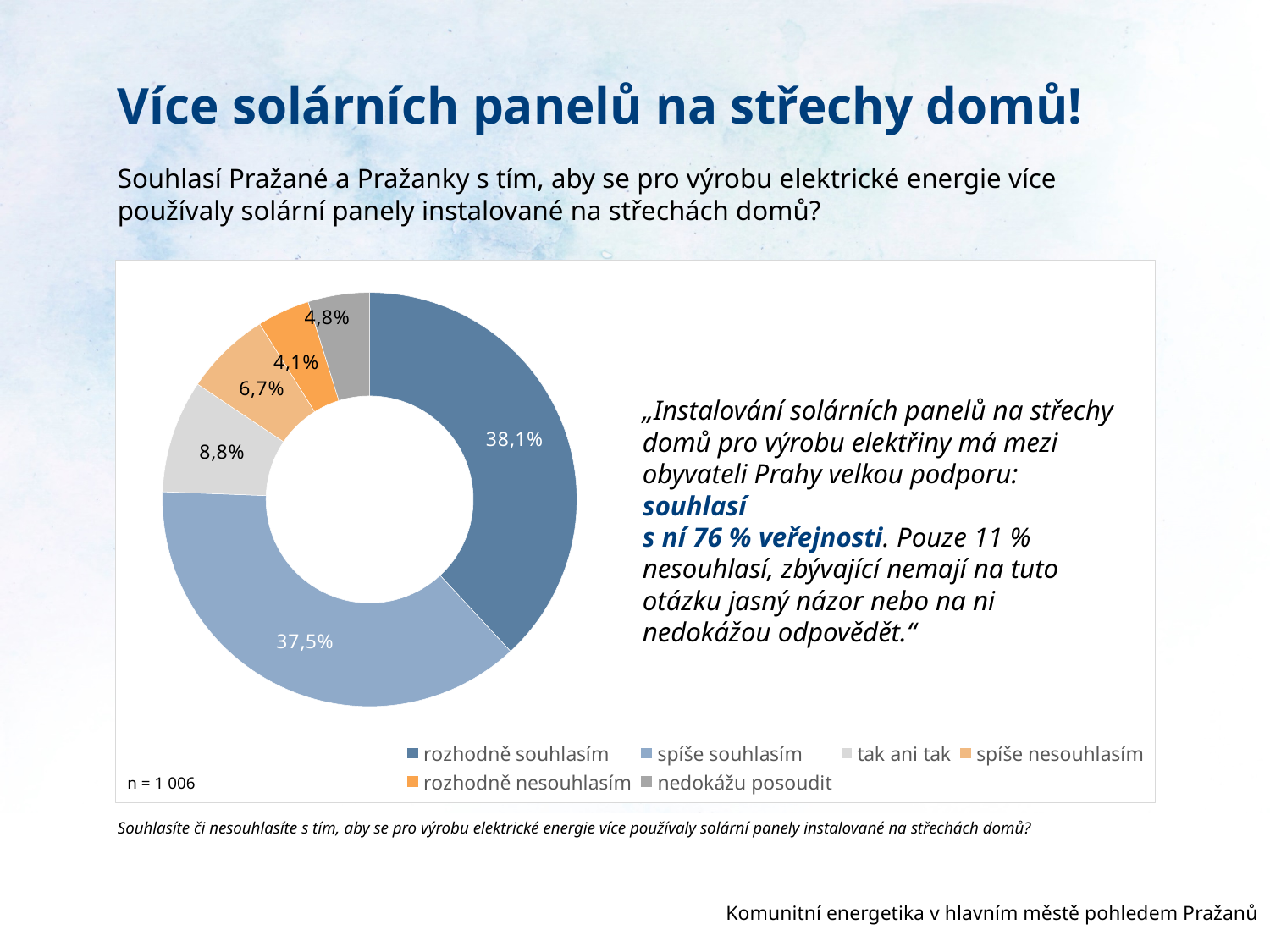
Which response category has the smallest share? rozhodně nesouhlasím Which response category has the largest share? rozhodně souhlasím How many response categories does the chart show? 6 What share of respondents answered "tak ani tak"? 8,8% What sample size (n) is stated on the slide? n = 1 006 What share of respondents answered "spíše souhlasím"? 37,5% What is the difference between the shares for "rozhodně souhlasím" and "spíše souhlasím"? 0,6% What kind of chart is shown on the slide? pie chart (doughnut) What share of respondents answered "nedokážu posoudit"? 4,8% Which is larger, the share for "spíše nesouhlasím" or for "tak ani tak"? tak ani tak What is the combined share of "rozhodně souhlasím" and "spíše souhlasím"? 75,6% What share of respondents answered "rozhodně souhlasím"? 38,1%